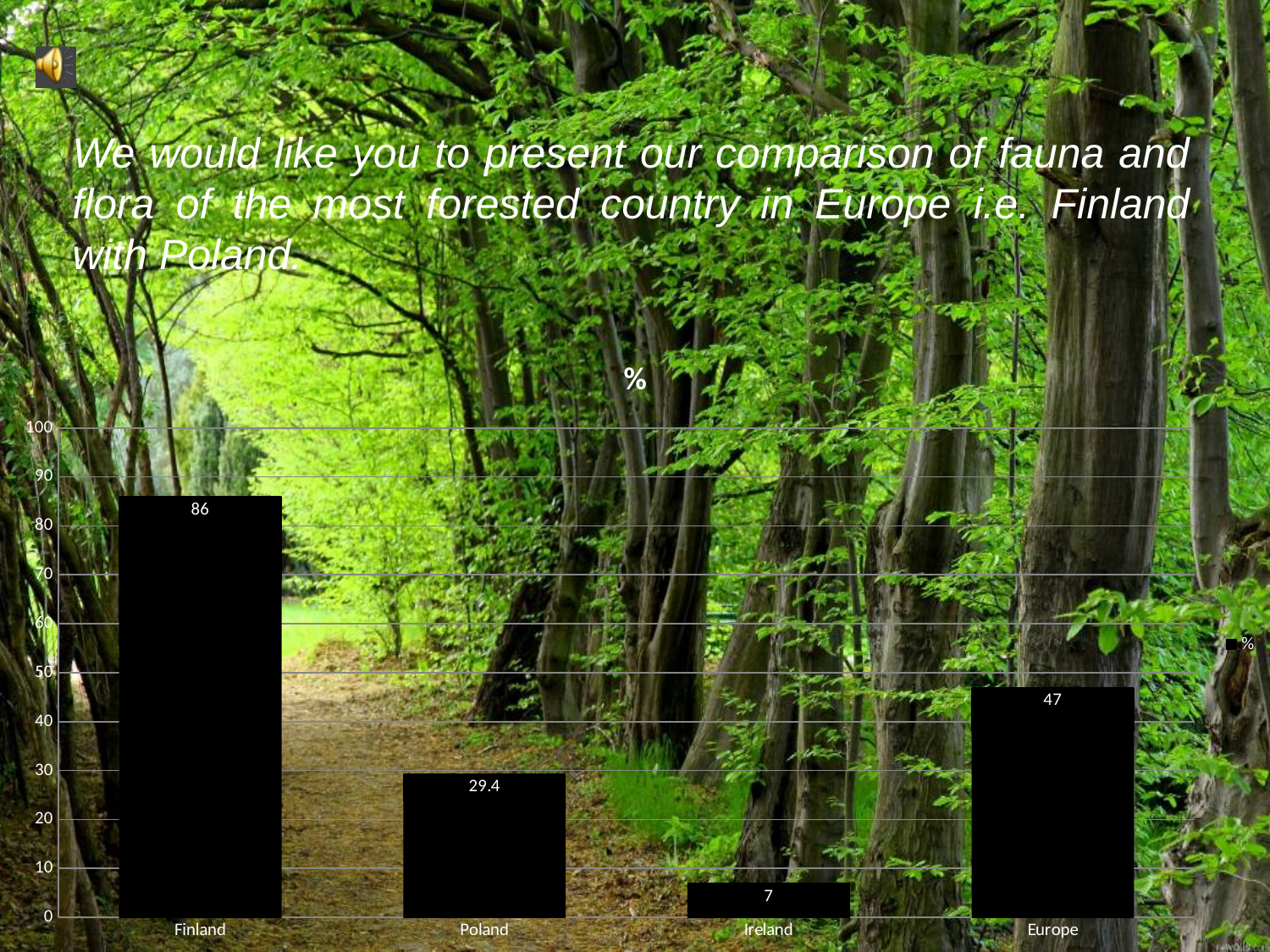
What is the value for Ireland? 7 What is the difference between the values for Europe and Ireland? 40 What is the value for Finland? 86 What is the value for Europe? 47 Which category has the highest value? Finland What kind of chart is shown? bar chart What is the title of the chart? % What is the difference between the values for Finland and Poland? 56.6 How many categories are shown on the x axis? 4 Which is larger, the value for Poland or the value for Europe? Europe Which category has the lowest value? Ireland What is the value for Poland? 29.4